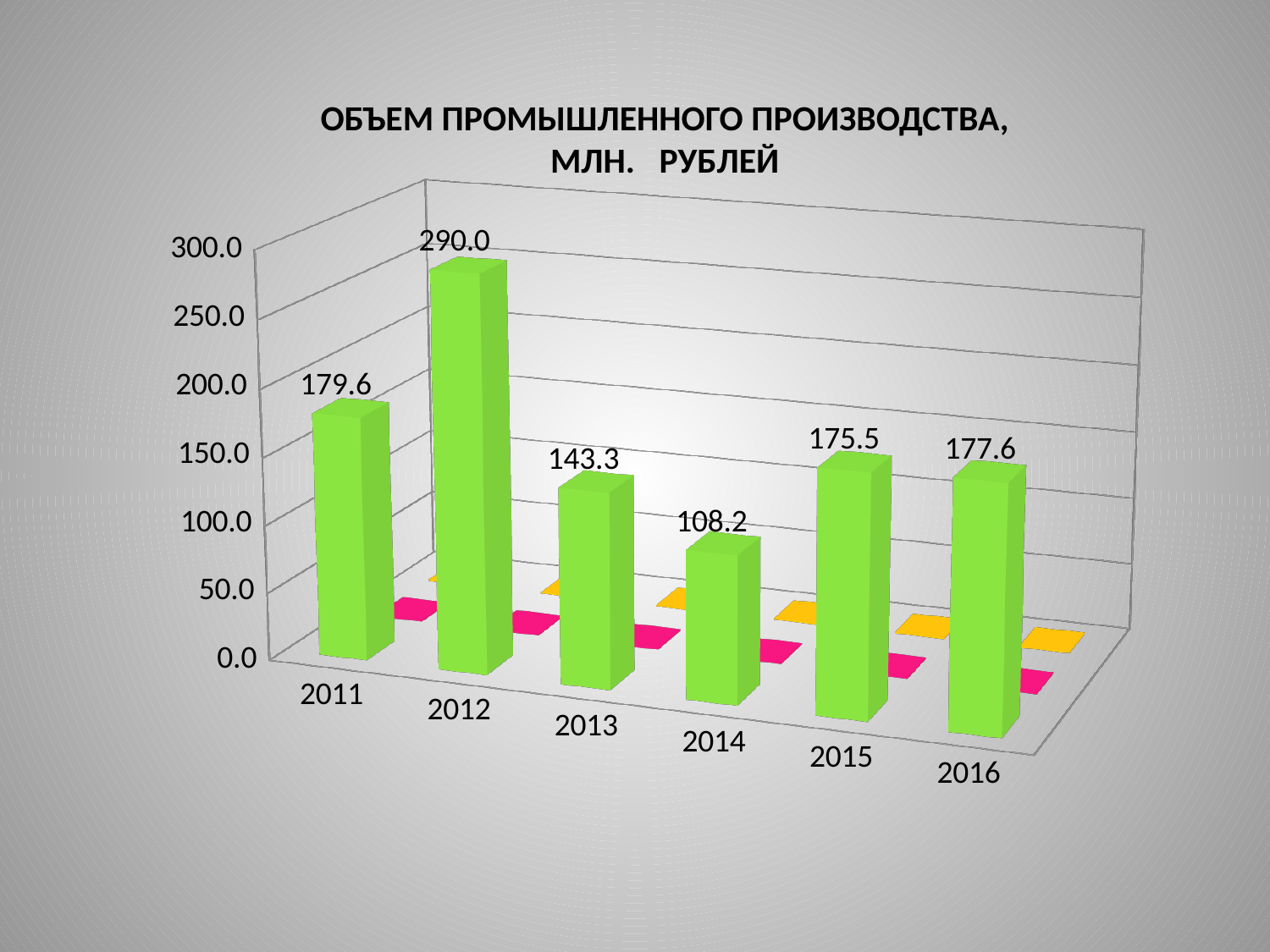
What is the difference between the values for 2012 and 2011? 110.4 What is the value for 2012? 290.0 Which is larger, the value for 2011 or the value for 2013? 2011 What is the difference between the values for 2011 and 2014? 71.4 What is the value for 2014? 108.2 What kind of chart is this? bar chart What is the value for 2016? 177.6 Between 2014 and 2016, do the values rise or fall? rise Which year has the highest value? 2012 Is the value for 2013 greater or less than 150.0? less Which year has the lowest value? 2014 How many years are shown on the x axis? 6